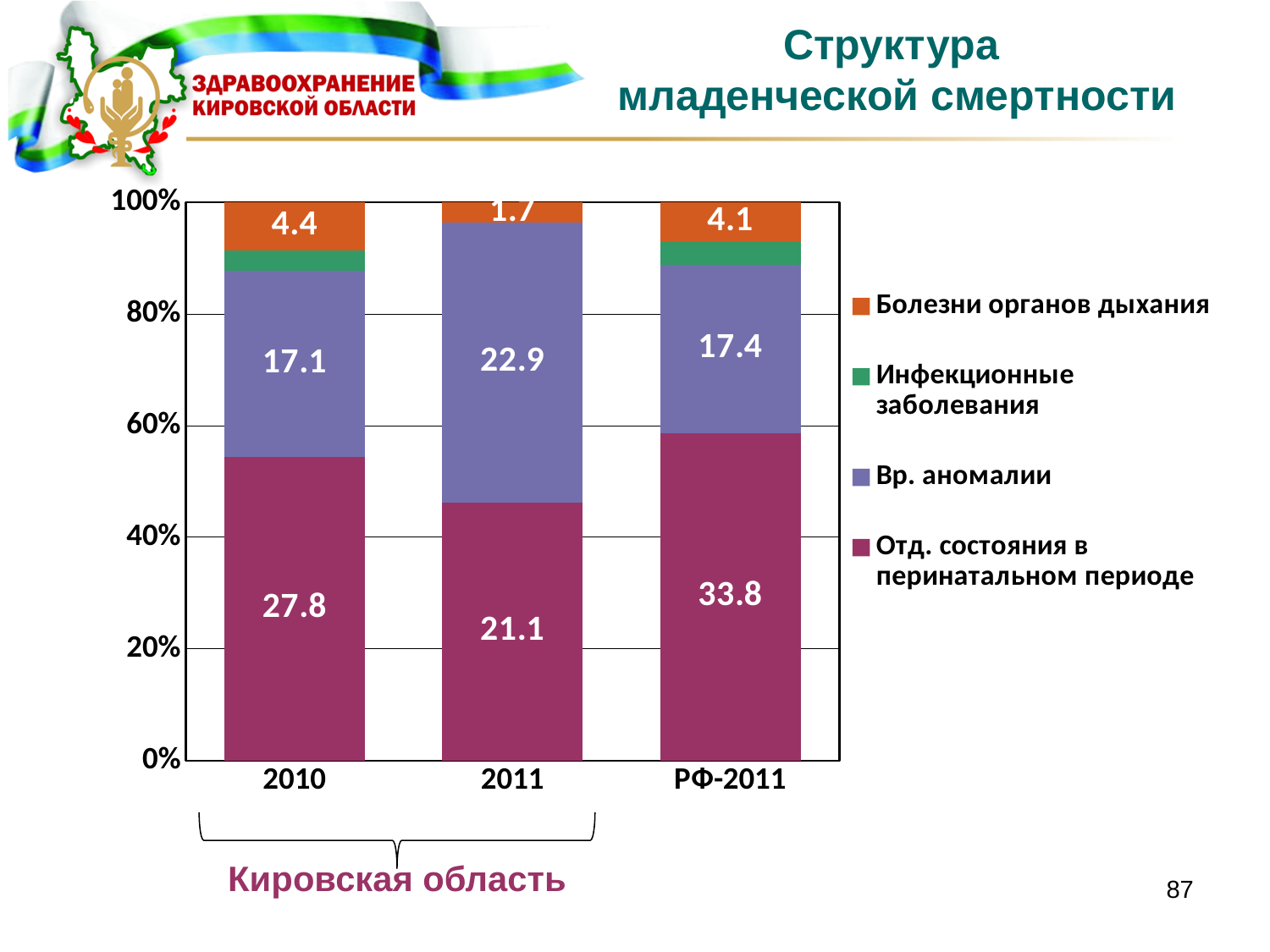
What is the value labelled for 'Болезни органов дыхания' in the 2010 bar? 4.4 What is the value labelled for 'Отд. состояния в перинатальном периоде' in the 2011 bar? 21.1 Which bar has the lowest labelled value for 'Болезни органов дыхания'? 2011 What is the value labelled for 'Отд. состояния в перинатальном периоде' in the 2010 bar? 27.8 How many bars are shown on the x axis? 3 What kind of chart is shown on the slide? Stacked bar chart How many series does the legend list? 4 Which bar has the highest labelled value for 'Отд. состояния в перинатальном периоде'? РФ-2011 Which is larger: the 'Отд. состояния в перинатальном периоде' value for 2010 or for 2011? 2010 What is the value labelled for 'Вр. аномалии' in the РФ-2011 bar? 17.4 What is the difference between the 'Вр. аномалии' values for 2011 and 2010? 5.8 Is the share of 'Отд. состояния в перинатальном периоде' in the 2011 bar greater or less than 40%? greater